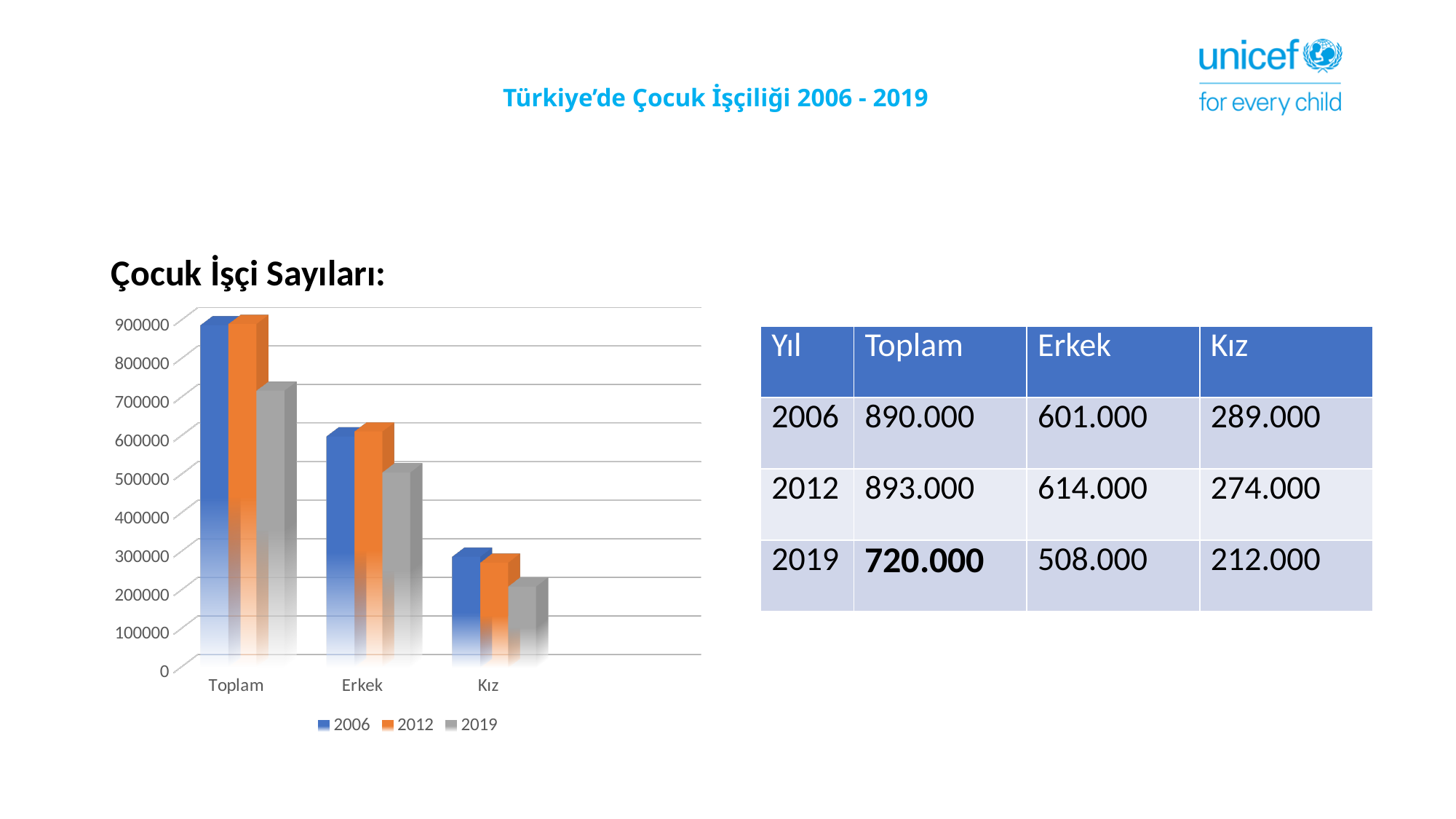
What is the Toplam value for 2019? 720.000 What kind of chart is shown on the slide? bar chart What is the Kız value for 2006? 289.000 How many categories are shown on the x axis of the chart? 3 How many series does the chart legend list? 3 Which years are listed in the chart legend? 2006, 2012, 2019 For Toplam, which is larger: the 2012 value or the 2019 value? 2012 What is the difference between the Toplam value for 2006 and the Toplam value for 2019? 170.000 Which category has the lowest values in the chart? Kız Is the Erkek value for 2019 greater or less than 400000? greater Is the Kız value for 2019 greater or less than 300000? less What is the Erkek value for 2012? 614.000